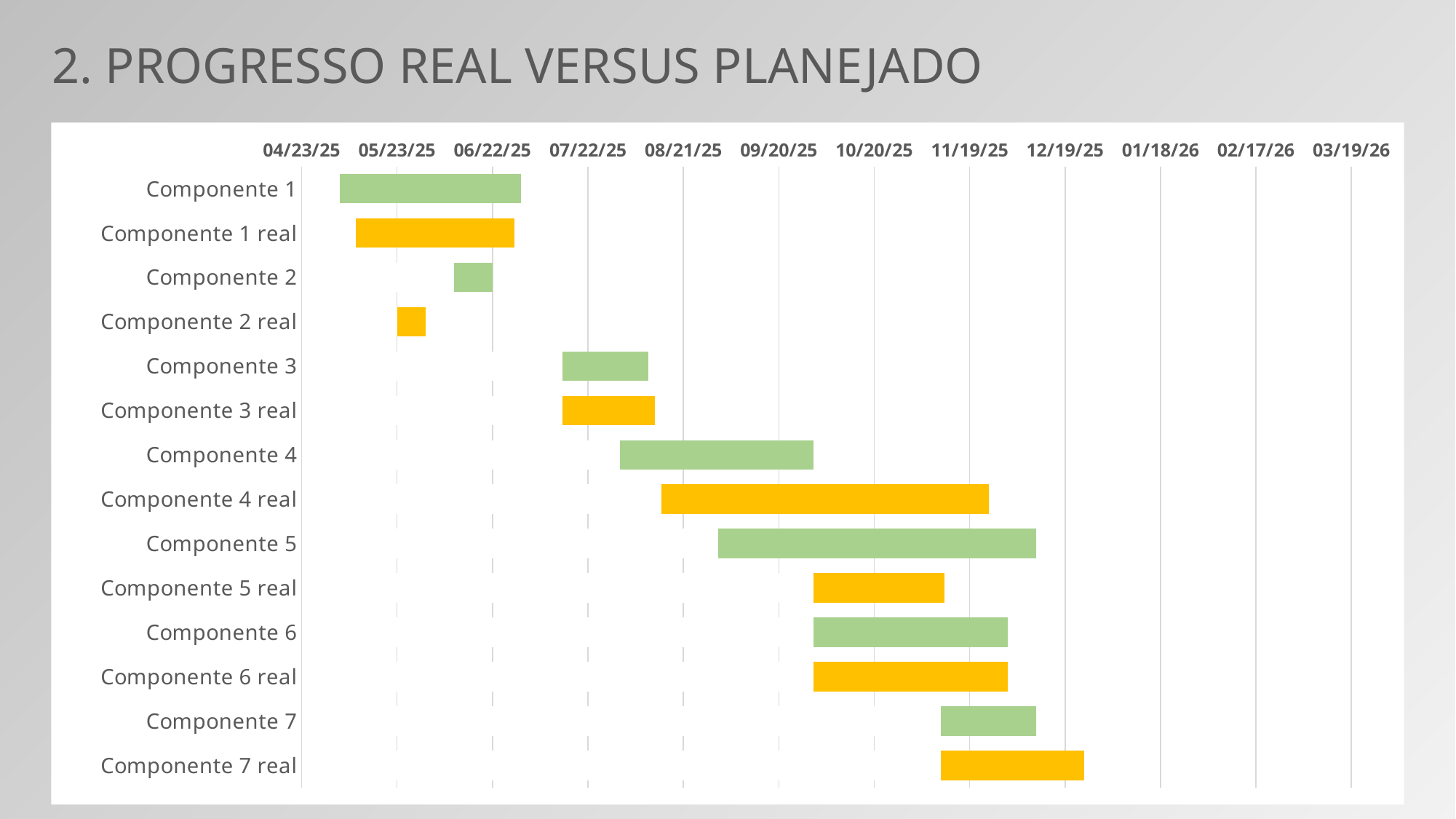
Which category has the shortest bar in the chart? Componente 2 real What is the title of the slide containing the chart? 2. PROGRESSO REAL VERSUS PLANEJADO Does the bar for Componente 3 start before or after 07/22/25? before Which bar is longer, Componente 4 or Componente 4 real? Componente 4 real Which bar is longer, Componente 5 or Componente 5 real? Componente 5 Does the bar for Componente 1 start before or after 05/23/25? before Which bar is longer, Componente 7 or Componente 7 real? Componente 7 real What kind of chart is shown on the slide? bar chart Does the bar for Componente 7 real end before or after 12/19/25? after What is the first date shown on the horizontal axis of the chart? 04/23/25 How many categories (rows) are listed on the vertical axis of the chart? 14